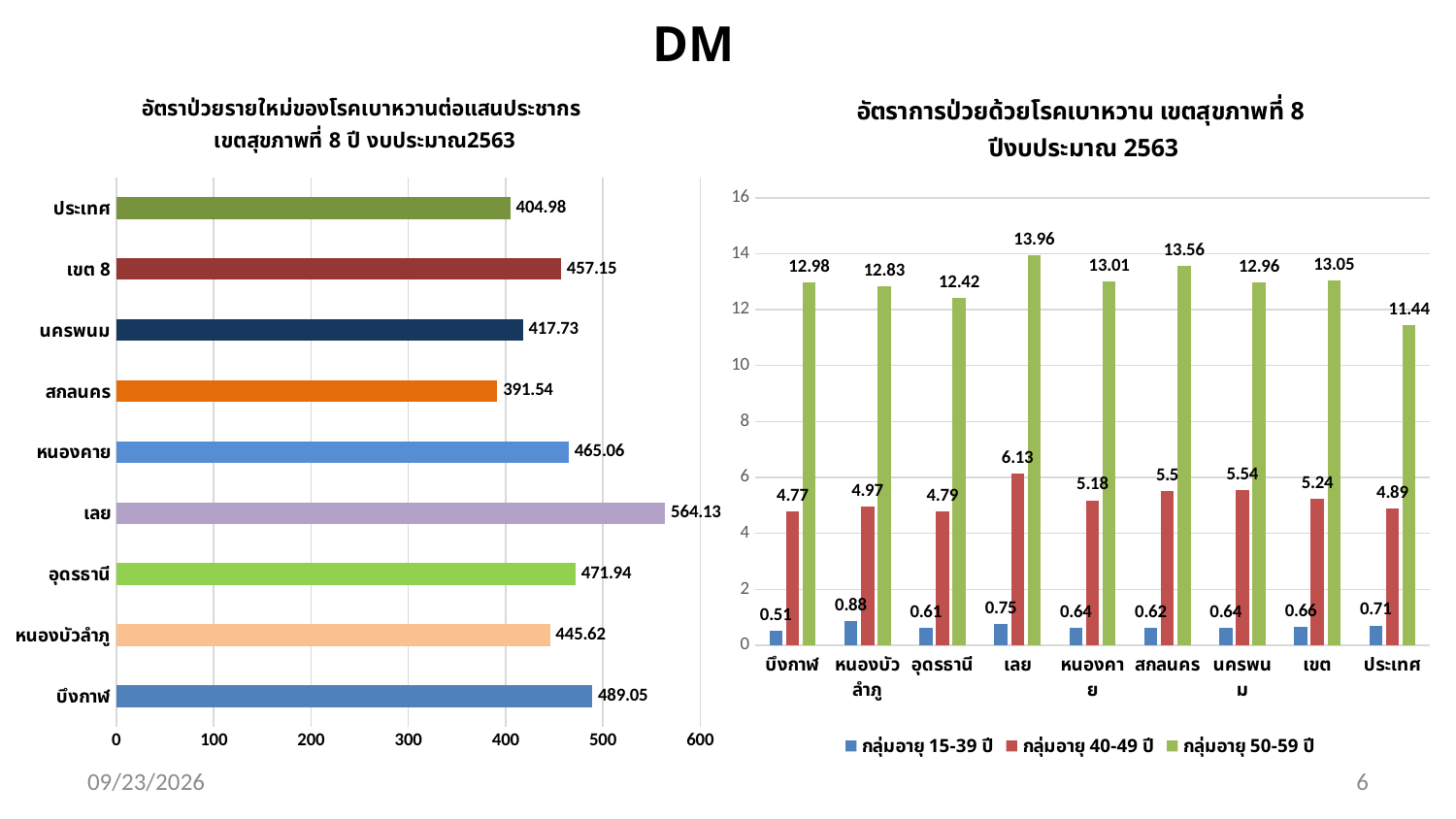
In the right chart (อัตราการป่วยด้วยโรคเบาหวาน เขตสุขภาพที่ 8), which is larger for กลุ่มอายุ 50-59 ปี: บึงกาฬ or ประเทศ? บึงกาฬ What kind of chart is the left chart (อัตราป่วยรายใหม่ของโรคเบาหวานต่อแสนประชากร)? Bar chart In the left chart (อัตราป่วยรายใหม่ของโรคเบาหวานต่อแสนประชากร), what is the value for ประเทศ? 404.98 In the left chart (อัตราป่วยรายใหม่ของโรคเบาหวานต่อแสนประชากร), what is the value for เลย? 564.13 In the right chart (อัตราการป่วยด้วยโรคเบาหวาน เขตสุขภาพที่ 8), which category has the highest value for กลุ่มอายุ 15-39 ปี? หนองบัวลำภู In the left chart (อัตราป่วยรายใหม่ของโรคเบาหวานต่อแสนประชากร), how many categories are shown? 9 In the right chart (อัตราการป่วยด้วยโรคเบาหวาน เขตสุขภาพที่ 8), what is the value for กลุ่มอายุ 50-59 ปี in เลย? 13.96 In the right chart (อัตราการป่วยด้วยโรคเบาหวาน เขตสุขภาพที่ 8), how many series does the legend list? 3 In the right chart (อัตราการป่วยด้วยโรคเบาหวาน เขตสุขภาพที่ 8), what is the value for กลุ่มอายุ 40-49 ปี in ประเทศ? 4.89 In the left chart (อัตราป่วยรายใหม่ของโรคเบาหวานต่อแสนประชากร), which category has the highest value? เลย In the left chart (อัตราป่วยรายใหม่ของโรคเบาหวานต่อแสนประชากร), what is the difference between เขต 8 and ประเทศ? 52.17 In the left chart (อัตราป่วยรายใหม่ของโรคเบาหวานต่อแสนประชากร), which category has the lowest value? สกลนคร